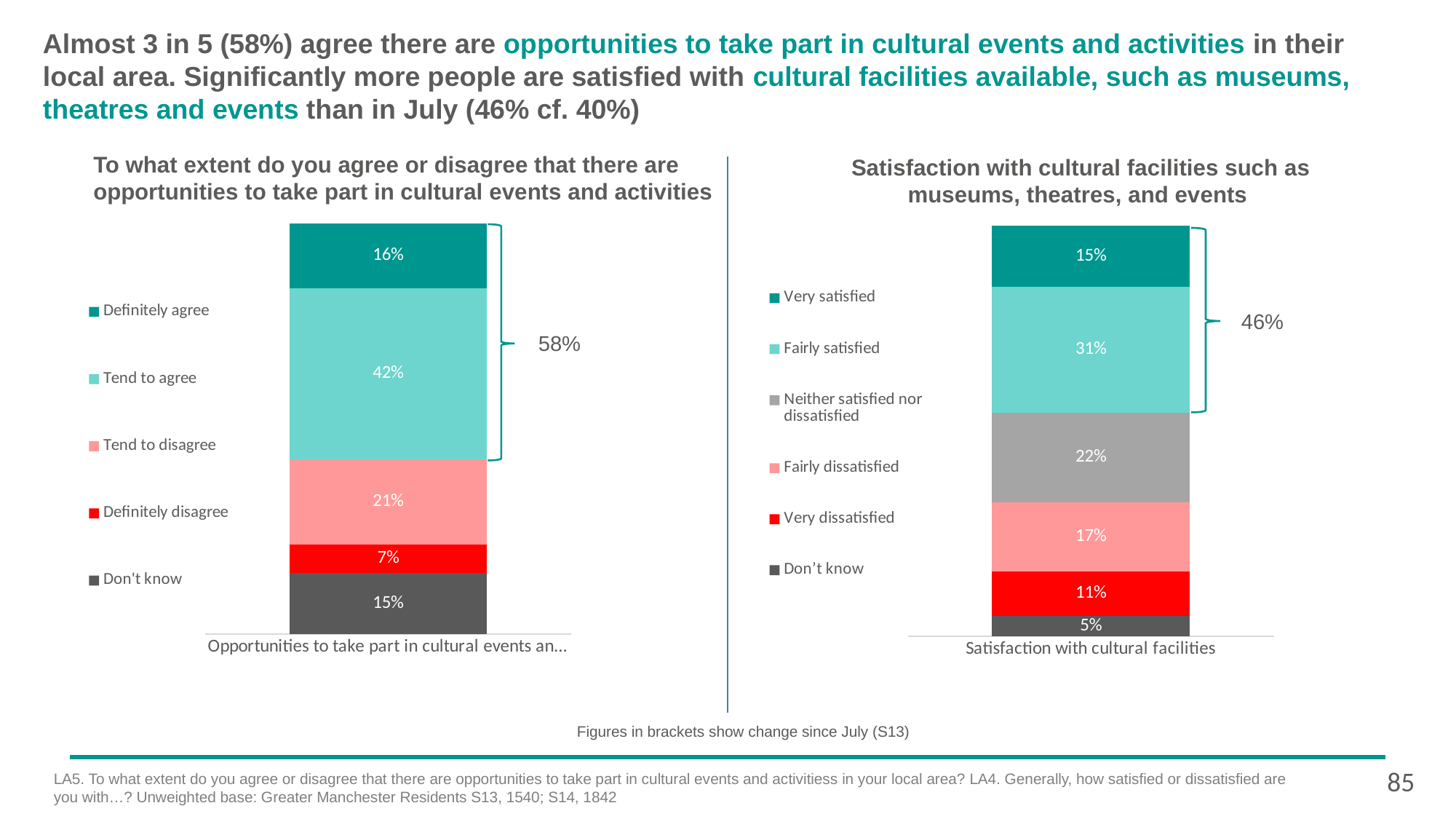
How many response categories does the legend of the right chart on satisfaction with cultural facilities list? 6 In the right chart on satisfaction with cultural facilities, what percentage is shown for 'Very dissatisfied'? 11% In the left chart on opportunities to take part in cultural events and activities, what percentage is shown for 'Definitely disagree'? 7% In the right chart on satisfaction with cultural facilities, what percentage is shown for 'Neither satisfied nor dissatisfied'? 22% What type of chart is the left chart on opportunities to take part in cultural events and activities? Stacked bar chart In the left chart on opportunities to take part in cultural events and activities, what is the difference between 'Tend to agree' and 'Tend to disagree'? 21 percentage points In the left chart on opportunities to take part in cultural events and activities, which response category has the largest share? Tend to agree In the right chart on satisfaction with cultural facilities, which is larger: 'Fairly dissatisfied' or 'Very dissatisfied'? Fairly dissatisfied In the left chart on opportunities to take part in cultural events and activities, what combined percentage is shown by the bracket for 'Definitely agree' and 'Tend to agree'? 58% In the right chart on satisfaction with cultural facilities, which response category has the smallest share? Don't know In the left chart on opportunities to take part in cultural events and activities, what percentage is shown for 'Tend to agree'? 42% In the right chart on satisfaction with cultural facilities, what combined percentage is shown by the bracket for 'Very satisfied' and 'Fairly satisfied'? 46%